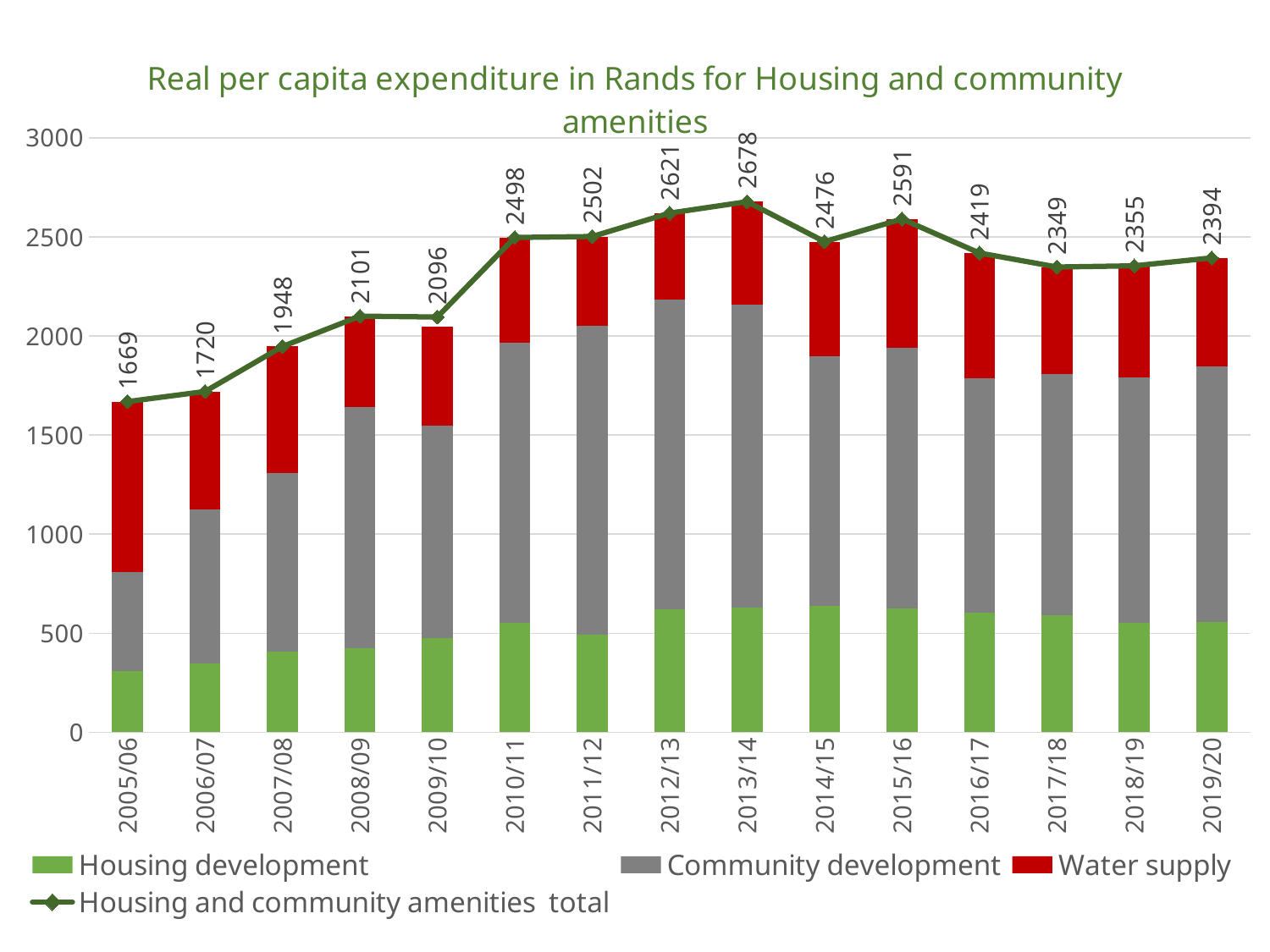
What is the Housing and community amenities total for 2019/20? 2394 How many series does the legend list? 4 How many years are shown on the x axis? 15 What is the Housing and community amenities total for 2005/06? 1669 Does the Housing and community amenities total rise or fall from 2005/06 to 2013/14? rise Which year has the larger Housing and community amenities total, 2012/13 or 2015/16? 2012/13 In which year is the Housing and community amenities total lowest? 2005/06 What is the Housing and community amenities total for 2013/14? 2678 What is the difference between the Housing and community amenities total in 2013/14 and in 2005/06? 1009 What kind of chart is used for the Housing development, Community development and Water supply series? bar chart In which year is the Housing and community amenities total highest? 2013/14 Is the value for Housing development in 2005/06 greater or less than 500? less